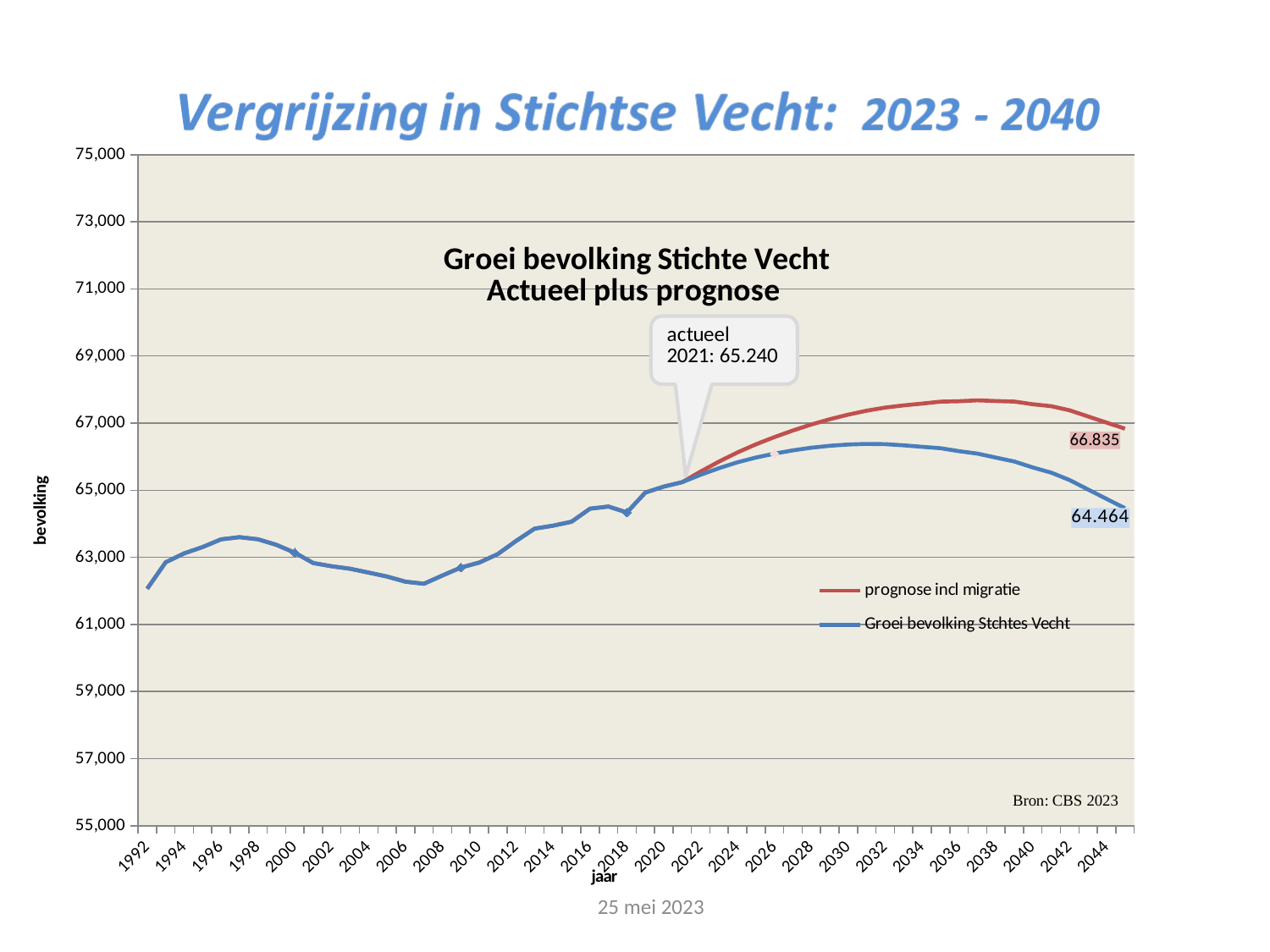
What kind of chart is shown on the slide? line chart Does the 'Groei bevolking Stchtes Vecht' line rise or fall between 2032 and 2044? fall Is the value of the 'prognose incl migratie' line in 2036 greater or less than 67,000? greater Is the value of the 'Groei bevolking Stchtes Vecht' line in 2008 greater or less than 63,000? less How many series does the legend list? 2 Does the 'Groei bevolking Stchtes Vecht' line rise or fall between 2008 and 2020? rise What is the difference between the labelled end values of the 'prognose incl migratie' series (66.835) and the 'Groei bevolking Stchtes Vecht' series (64.464)? 2.371 What source is cited in the bottom right corner of the chart? Bron: CBS 2023 What is the labelled end value of the 'Groei bevolking Stchtes Vecht' series? 64.464 According to the callout, what is the actual (actueel) population value for 2021? 65.240 Which series ends higher at the right end of the chart, 'prognose incl migratie' or 'Groei bevolking Stchtes Vecht'? prognose incl migratie What is the labelled end value of the 'prognose incl migratie' series? 66.835